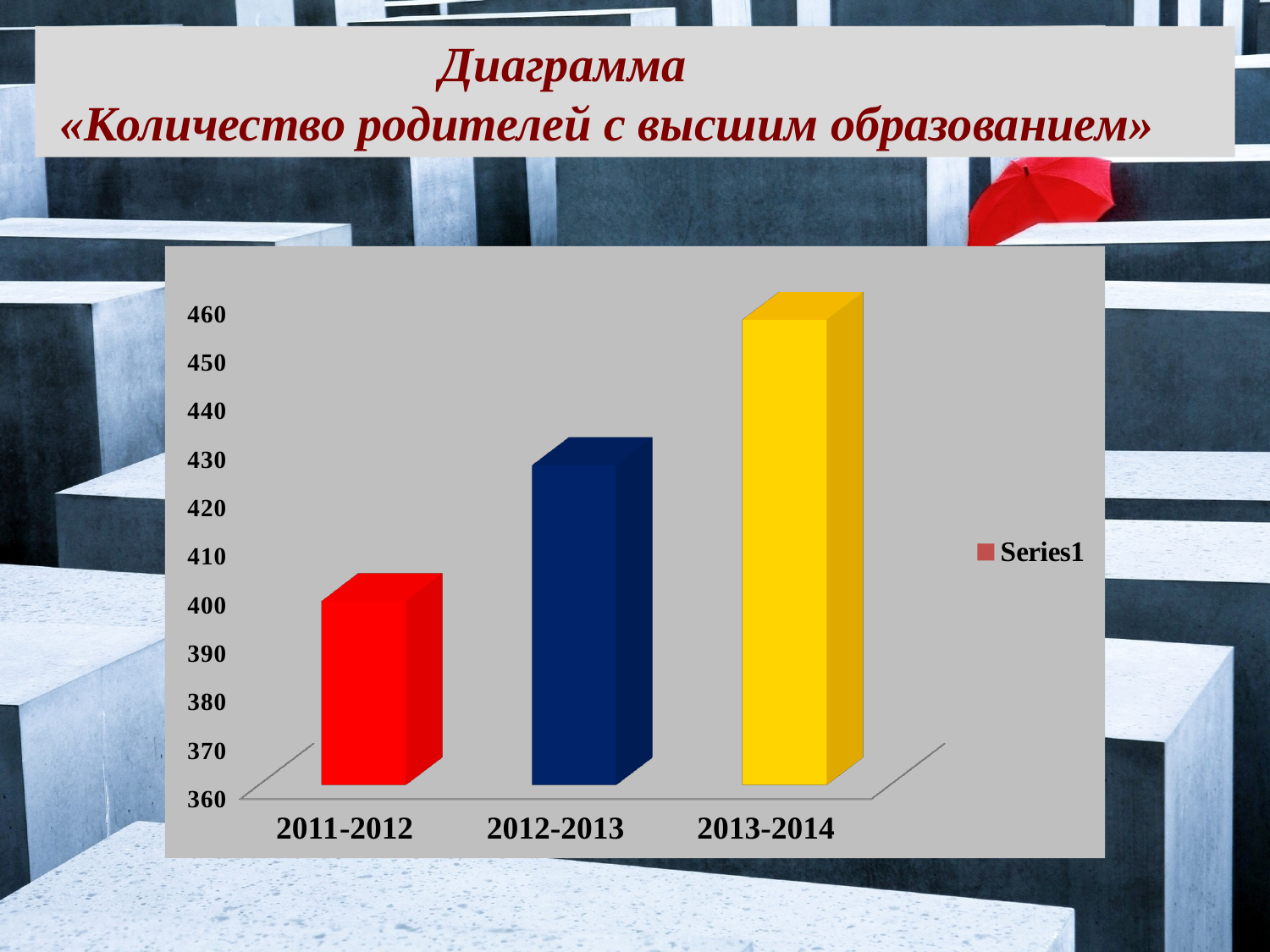
Is the value for 2013-2014 greater or less than 450? greater Do the values rise or fall from 2011-2012 to 2013-2014? rise How many categories are shown on the x axis of the chart? 3 Which category has the lowest bar in the chart? 2011-2012 Which is larger, the value for 2012-2013 or the value for 2011-2012? 2012-2013 Which category has the highest bar in the chart? 2013-2014 How many series does the chart legend list? 1 Is the value for 2011-2012 greater or less than 390? greater What colour is the bar for 2013-2014? yellow What is the name of the series shown in the chart legend? Series1 What kind of chart is shown on the slide? bar chart Is the value for 2012-2013 greater or less than 440? less